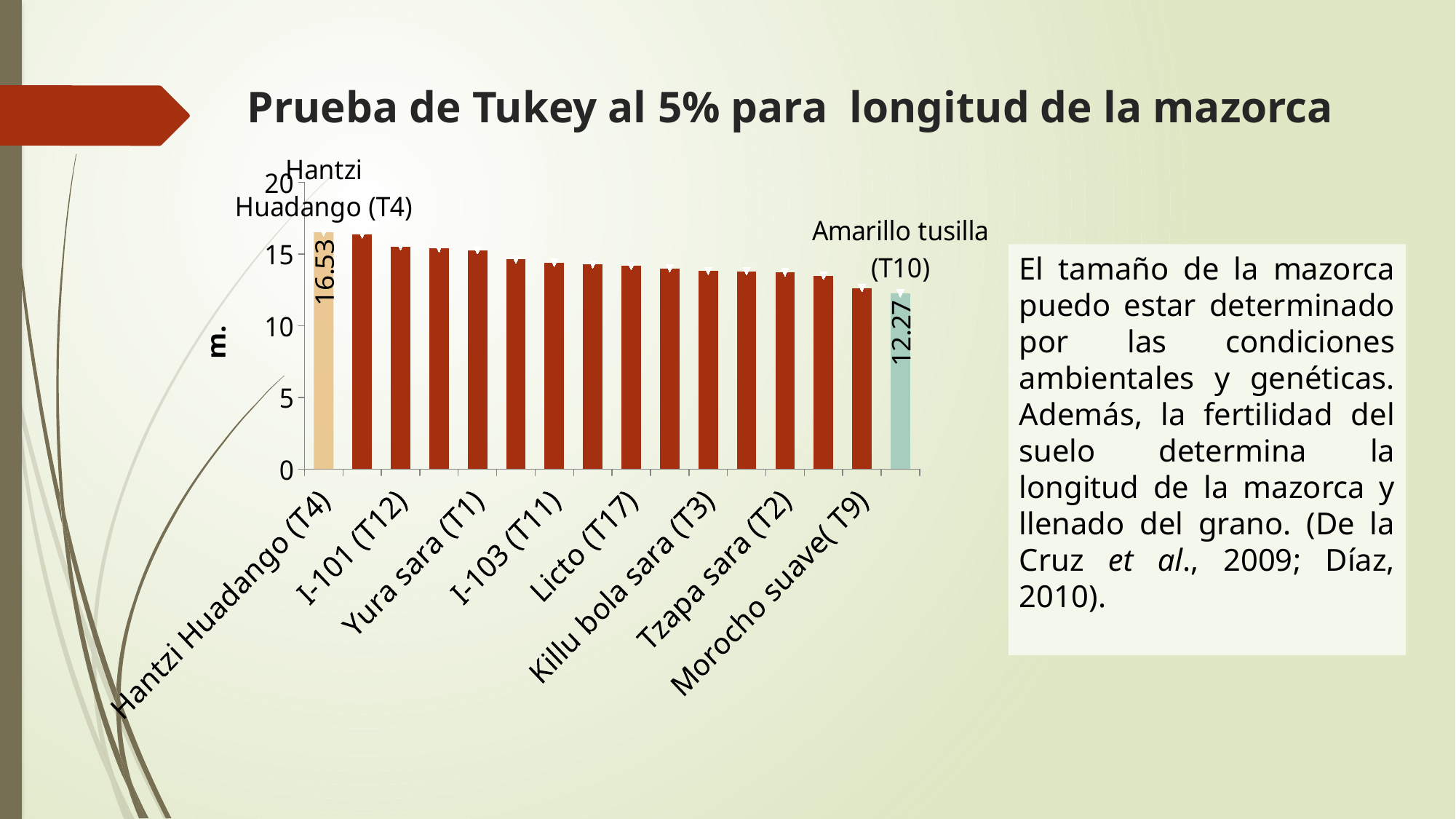
Which category has the highest value? Hantzi Huadango (T4) Is the value for I-101 (T12) greater or less than 15? greater Do the values rise or fall from left to right along the x axis? fall What kind of chart is shown on the slide? bar chart What is the difference between the values for Hantzi Huadango (T4) and Amarillo tusilla (T10)? 4.26 Which category has the lowest value? Amarillo tusilla (T10) What is the value for Amarillo tusilla (T10)? 12.27 Is the value for Morocho suave (T9) greater or less than 15? less Is the value for Licto (T17) greater or less than 15? less What is the title of the chart? Prueba de Tukey al 5% para longitud de la mazorca Which is larger, the value for I-101 (T12) or the value for Morocho suave (T9)? I-101 (T12) What is the value for Hantzi Huadango (T4)? 16.53